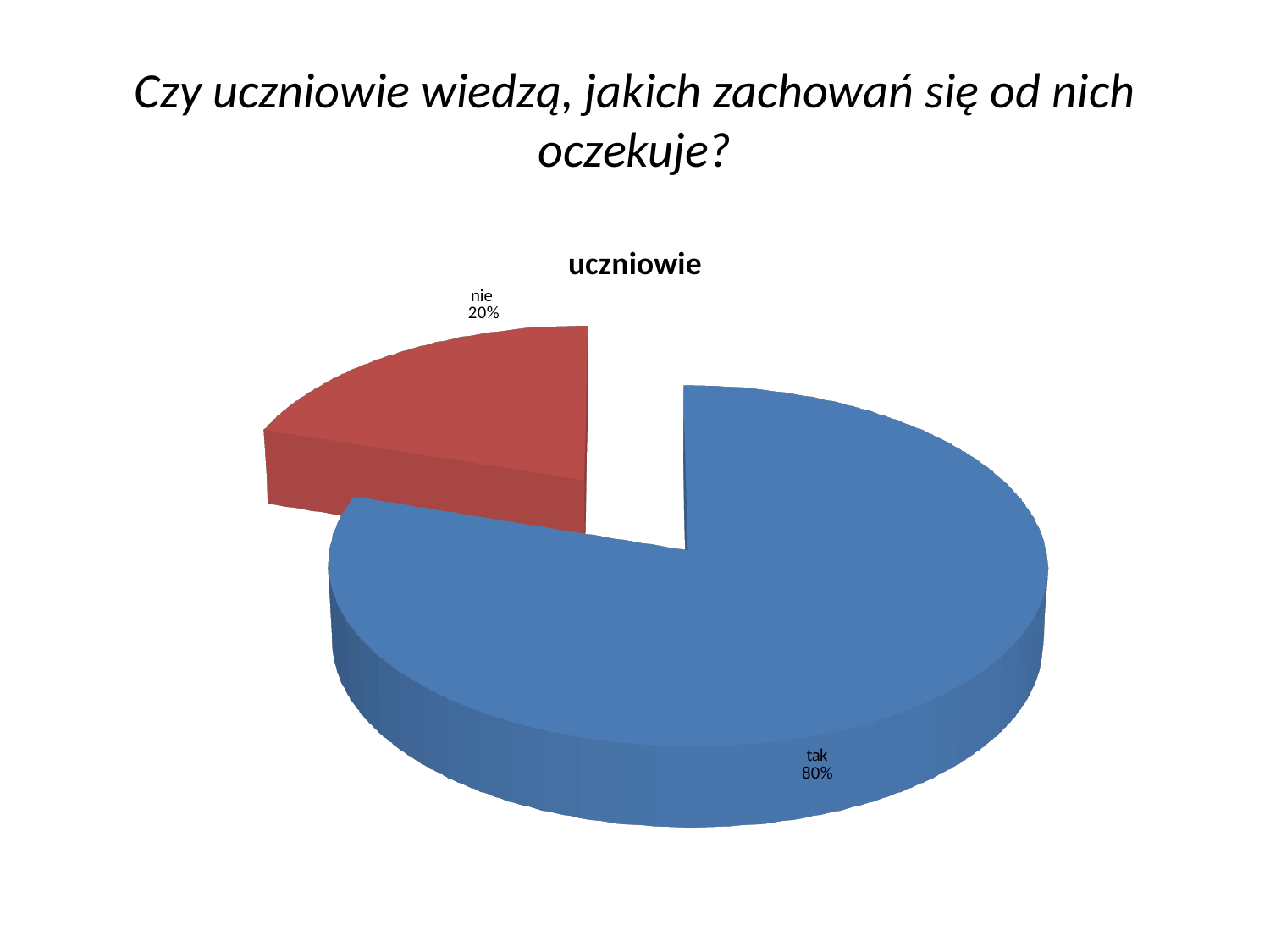
What share of the pie does the "nie" slice represent? 20% Which slice is the smallest in the pie chart? nie Which is larger, the "tak" slice or the "nie" slice? tak Which slice is the largest in the pie chart? tak How many slices does the pie chart have? 2 What is the title of the chart? uczniowie What kind of chart is shown on the slide? pie chart What share of the pie does the "tak" slice represent? 80% What is the difference in percentage points between the "tak" and "nie" slices? 60 percentage points What colour is the "nie" slice? red